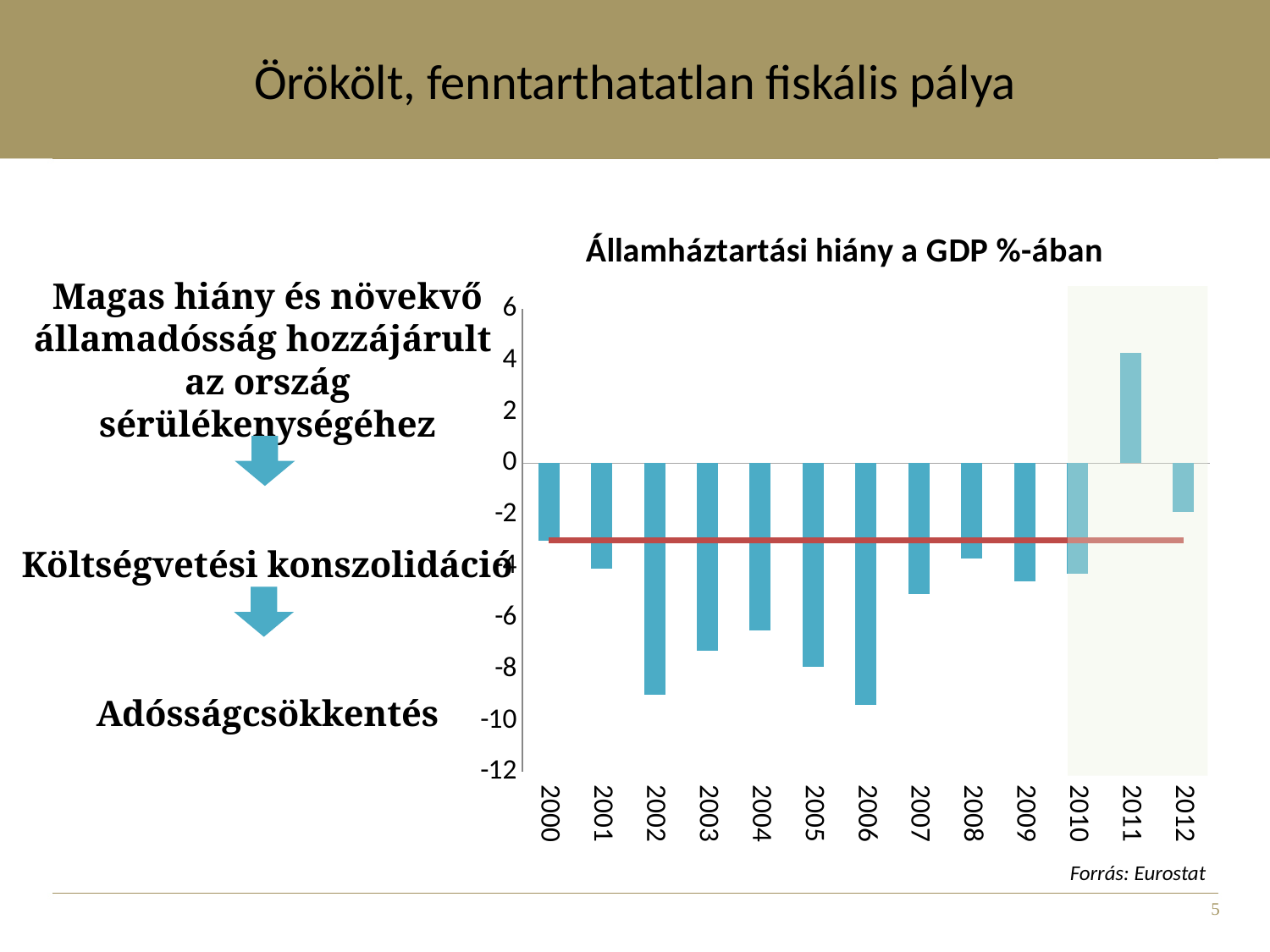
Is the value for 2007 greater or less than -4? less What is the source cited below the chart? Eurostat Is the value for 2002 greater or less than -8? less Is the value for 2012 greater or less than -4? greater Which year has the larger value, 2008 or 2009? 2008 How many years are shown on the x axis of the chart? 13 What is the title of the chart? Államháztartási hiány a GDP %-ában Which year has the highest value in the chart? 2011 Which year has the lowest value in the chart? 2006 What kind of chart is shown on the slide? bar and line chart Which year has the larger value, 2004 or 2006? 2004